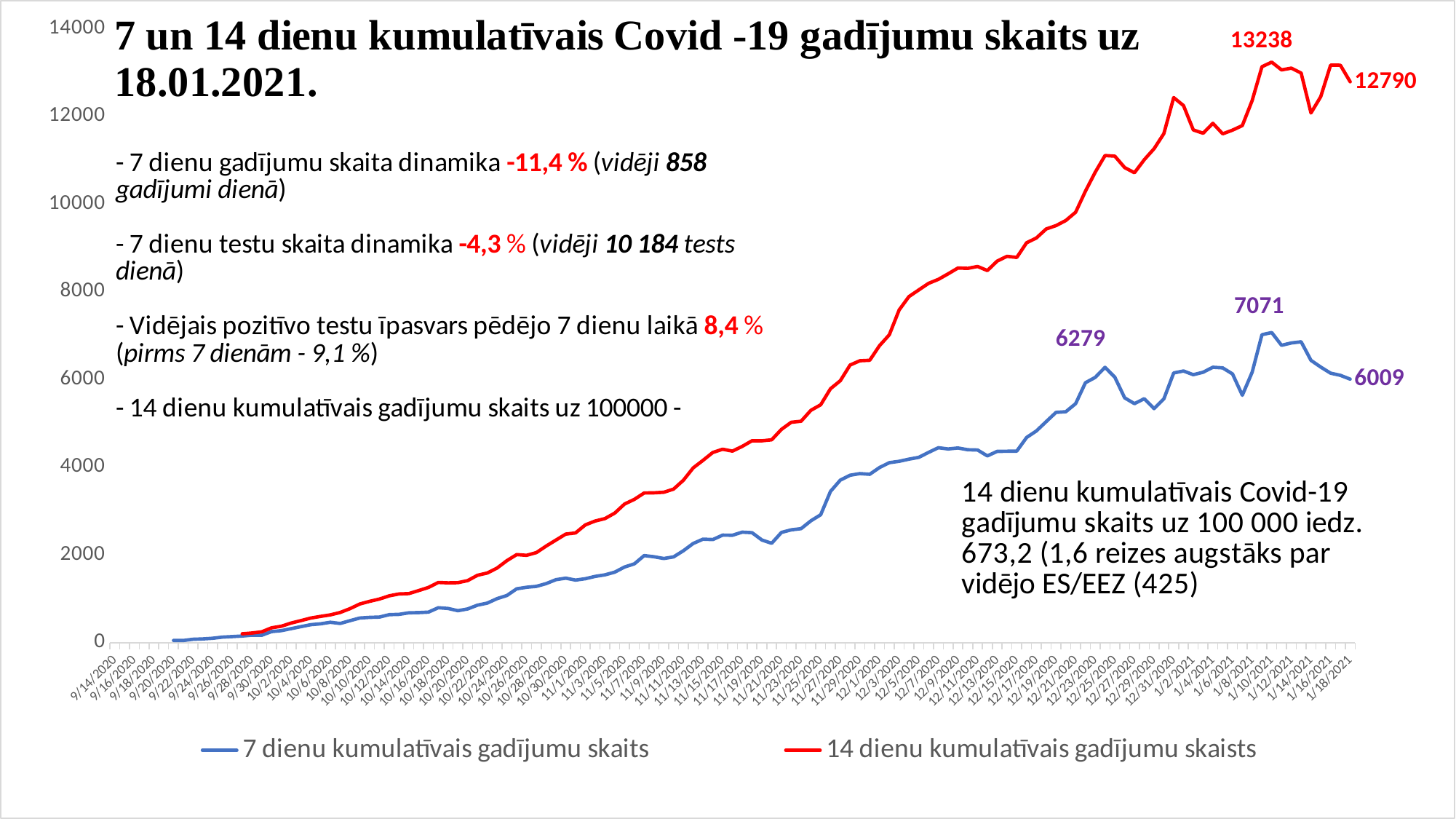
What is the last labelled value of the 7 dienu kumulatīvais gadījumu skaits series? 6009 Do the values of the 14 dienu kumulatīvais gadījumu skaists series generally rise or fall from September 2020 to January 2021? rise What colour is the line for the 14 dienu kumulatīvais gadījumu skaists series? red What is the highest labelled value on the 14 dienu kumulatīvais gadījumu skaists line? 13238 What is the highest labelled value on the 7 dienu kumulatīvais gadījumu skaits line? 7071 Is the value of the 14 dienu kumulatīvais gadījumu skaists series at 11/1/2020 greater or less than 2000? greater What is the difference between the labelled values 7071 and 6009 on the 7-day series? 1062 What type of chart is shown on the slide? line chart How many series does the legend list? 2 What is the difference between the labelled peak 13238 and the final value 12790 of the 14-day series? 448 At the end of the chart, which series has the larger value: the 7-day or the 14-day cumulative count? 14 dienu kumulatīvais gadījumu skaists What is the last labelled value of the 14 dienu kumulatīvais gadījumu skaists series? 12790